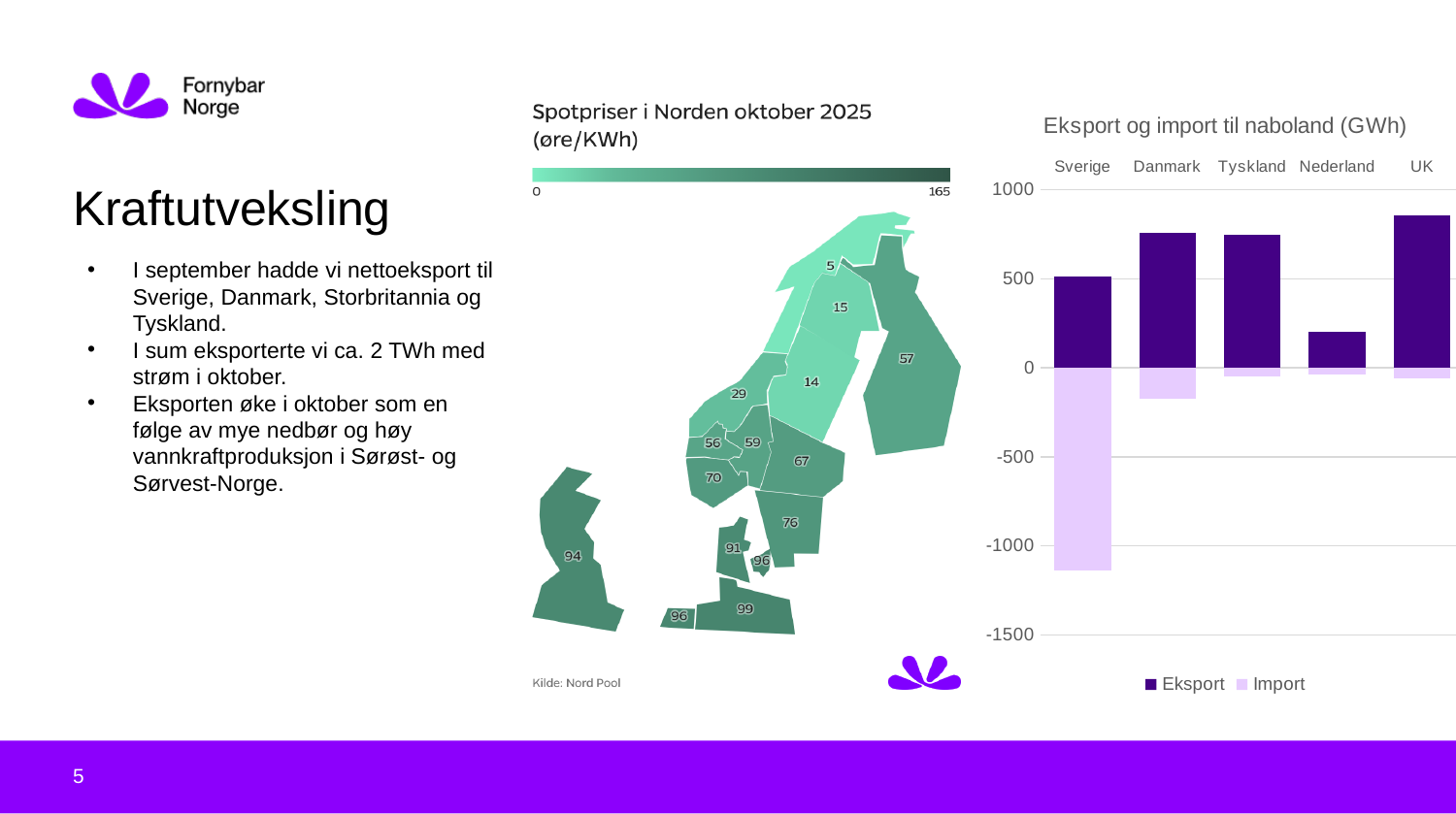
In the 'Eksport og import til naboland (GWh)' chart, which is larger: the Eksport value for UK or for Sverige? UK How many countries are shown on the x axis of the 'Eksport og import til naboland (GWh)' chart? 5 In the 'Eksport og import til naboland (GWh)' chart, is the Import value for Sverige greater or less than -1000? less In the 'Eksport og import til naboland (GWh)' chart, which country has the highest Eksport value? UK On the map 'Spotpriser i Norden oktober 2025 (øre/KWh)', what is the highest price value printed? 99 In the 'Eksport og import til naboland (GWh)' chart, which series is shown in dark purple? Eksport What type of chart is 'Eksport og import til naboland (GWh)'? bar chart In the 'Eksport og import til naboland (GWh)' chart, which country has the largest Import bar? Sverige In the 'Eksport og import til naboland (GWh)' chart, which country has the lowest Eksport value? Nederland In the 'Eksport og import til naboland (GWh)' chart, is the Eksport value for Danmark greater or less than 500? greater In the 'Eksport og import til naboland (GWh)' chart, is the Eksport value for Nederland greater or less than 500? less How many series does the legend of the 'Eksport og import til naboland (GWh)' chart list? 2